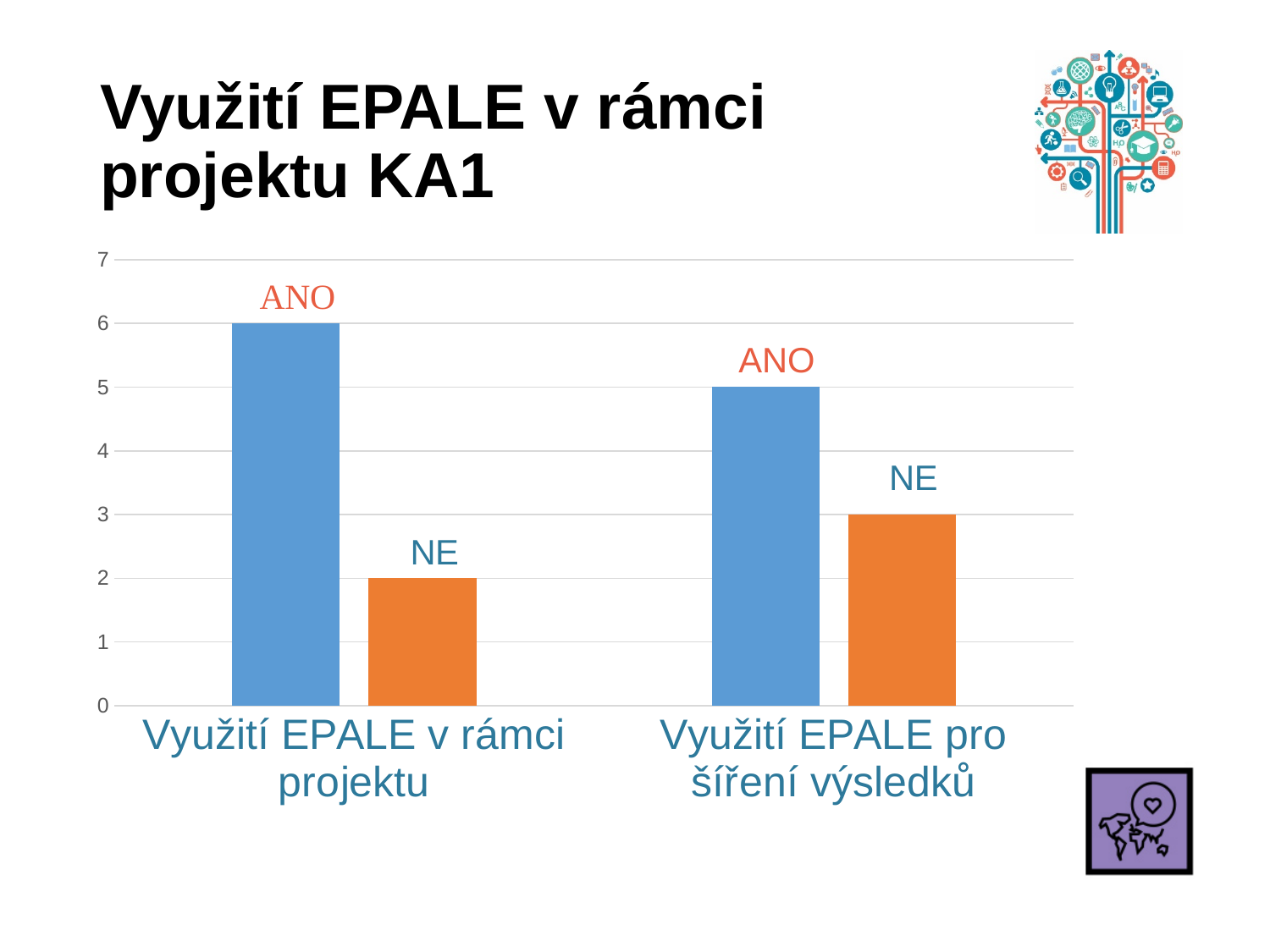
What type of chart is shown on the slide? bar chart What is the value of the NE bar for "Využití EPALE v rámci projektu"? 2 What is the difference between the ANO and NE values for "Využití EPALE v rámci projektu"? 4 Which bar is the tallest in the chart? ANO for Využití EPALE v rámci projektu What is the value of the NE bar for "Využití EPALE pro šíření výsledků"? 3 What is the value of the ANO bar for "Využití EPALE pro šíření výsledků"? 5 What colour are the ANO bars in the chart? blue What is the value of the ANO bar for "Využití EPALE v rámci projektu"? 6 Which is larger: the ANO value for "Využití EPALE v rámci projektu" or the ANO value for "Využití EPALE pro šíření výsledků"? Využití EPALE v rámci projektu How many categories are shown on the x axis of the chart? 2 Which bar is the shortest in the chart? NE for Využití EPALE v rámci projektu What is the difference between the ANO and NE values for "Využití EPALE pro šíření výsledků"? 2